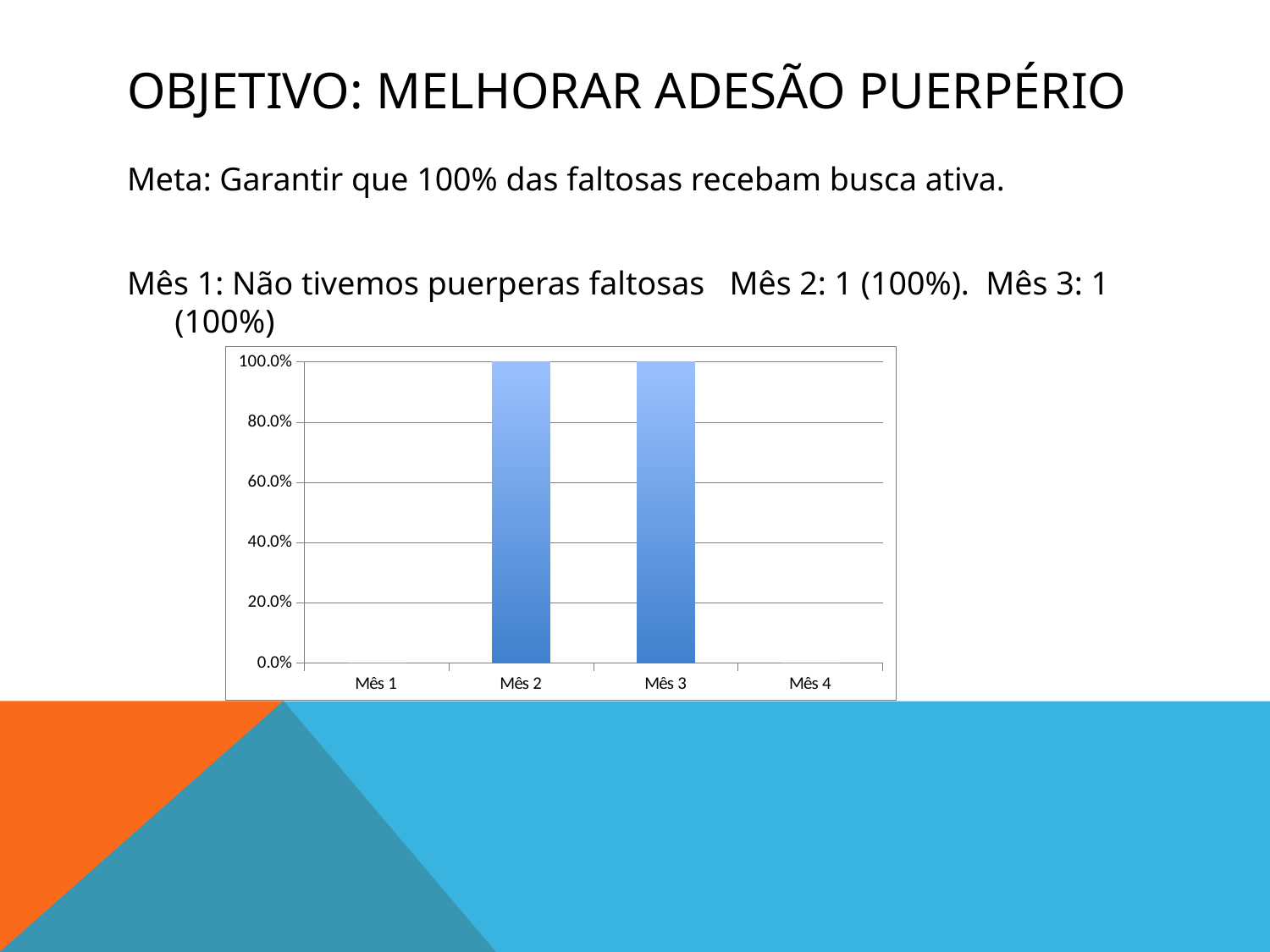
Which categories in the chart have no visible bar? Mês 1 and Mês 4 What is the highest value shown on the y axis of the chart? 100.0% Which is larger in the chart, the value for Mês 1 or the value for Mês 2? Mês 2 Is the value for Mês 2 greater or less than 80.0%? greater What is the value for Mês 3 in the chart? 100.0% Is the value for Mês 3 greater or less than 60.0%? greater How many categories are shown on the x axis of the chart? 4 What is the difference between the values for Mês 2 and Mês 3 in the chart? 0.0% What kind of chart is shown on the slide? bar chart Which is larger in the chart, the value for Mês 3 or the value for Mês 4? Mês 3 What is the value for Mês 2 in the chart? 100.0% What is the label of the last category on the x axis of the chart? Mês 4